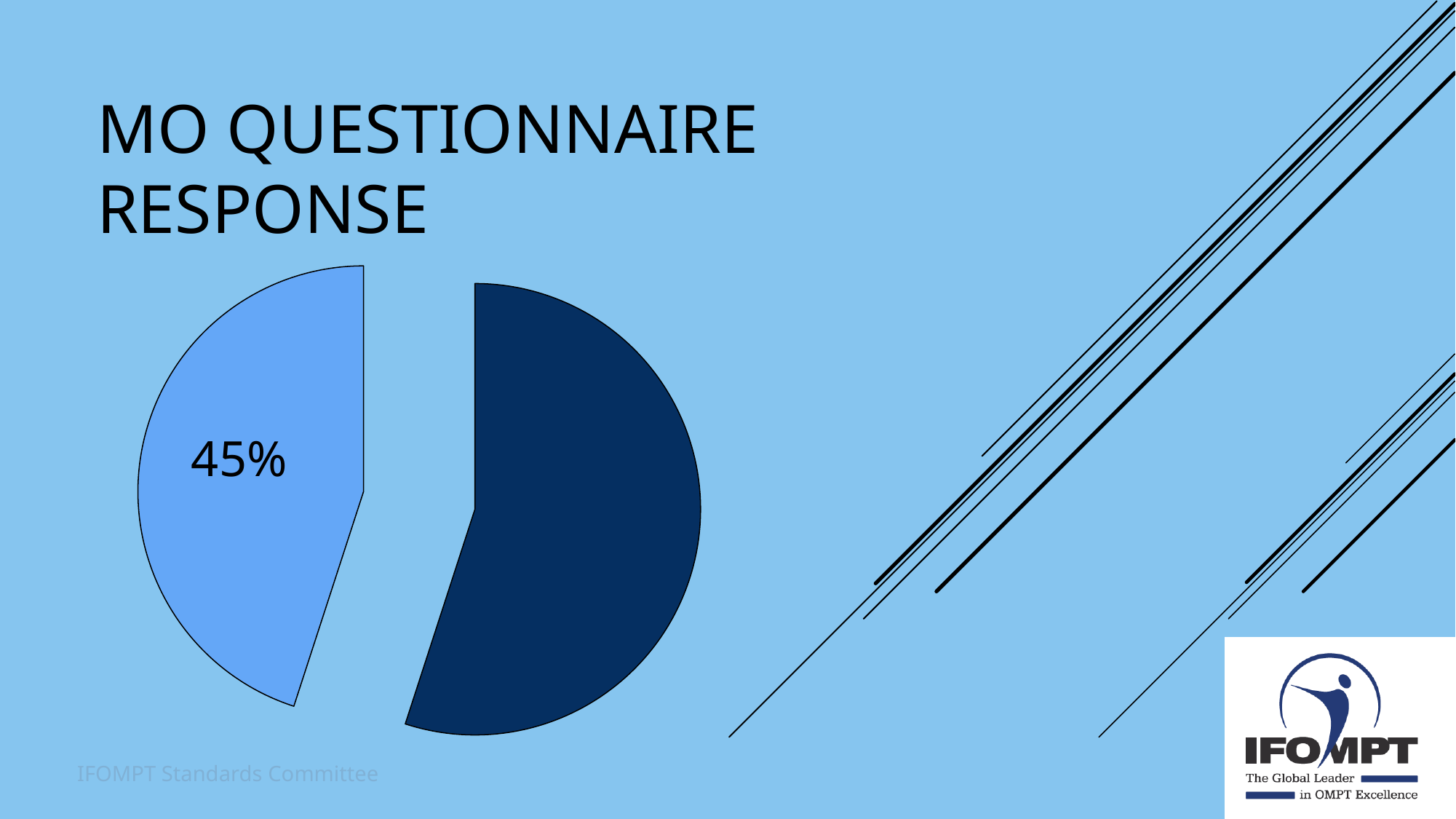
Which slice of the pie chart carries a printed data label? the light blue slice What kind of chart is shown on the slide? pie chart Which slice of the pie chart is the smallest? the light blue slice Which slice of the pie chart is larger, the light blue slice or the dark blue slice? the dark blue slice What percentage is printed on the light blue slice of the pie chart? 45% How many slices does the pie chart have? 2 Is the share of the light blue slice greater or less than 50%? less What is the title of the slide containing the pie chart? MO QUESTIONNAIRE RESPONSE Which slice of the pie chart is the largest? the dark blue slice Is the share of the dark blue slice greater or less than 50%? greater